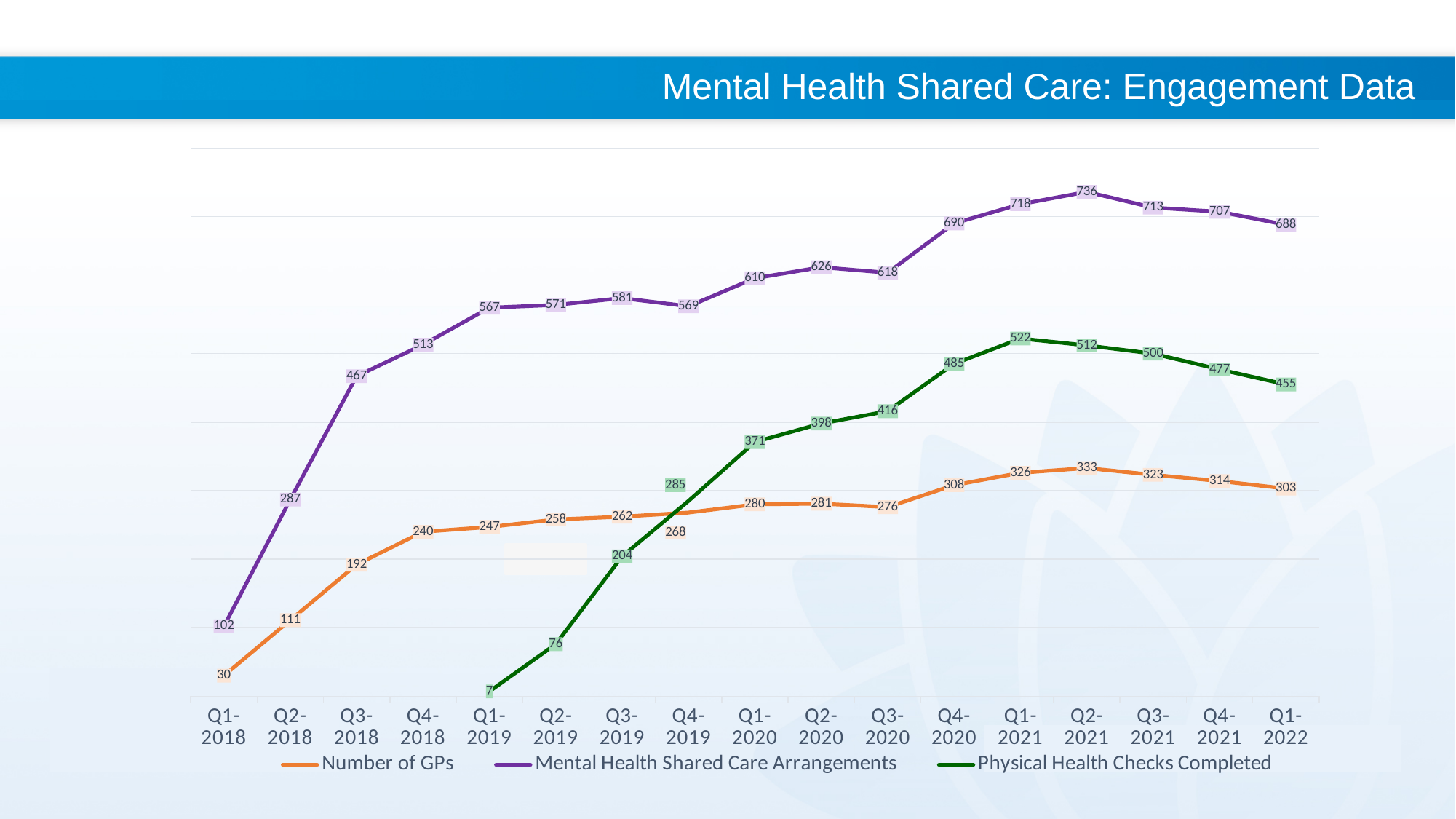
What is the value for Mental Health Shared Care Arrangements in Q2-2021? 736 Which is larger in Q4-2019: the Number of GPs or Physical Health Checks Completed? Physical Health Checks Completed What is the difference between Mental Health Shared Care Arrangements in Q1-2022 and Q1-2018? 586 Does the Mental Health Shared Care Arrangements series rise or fall from Q1-2018 to Q2-2021? Rise In which quarter is the Physical Health Checks Completed value lowest? Q1-2019 What is the Number of GPs in Q1-2018? 30 How many series does the legend list? 3 How many quarters are shown on the x axis? 17 In which quarter does the Number of GPs reach its highest value? Q2-2021 What is the title of the slide? Mental Health Shared Care: Engagement Data How many Physical Health Checks were completed in Q4-2020? 485 What kind of chart is shown on the slide? Line chart